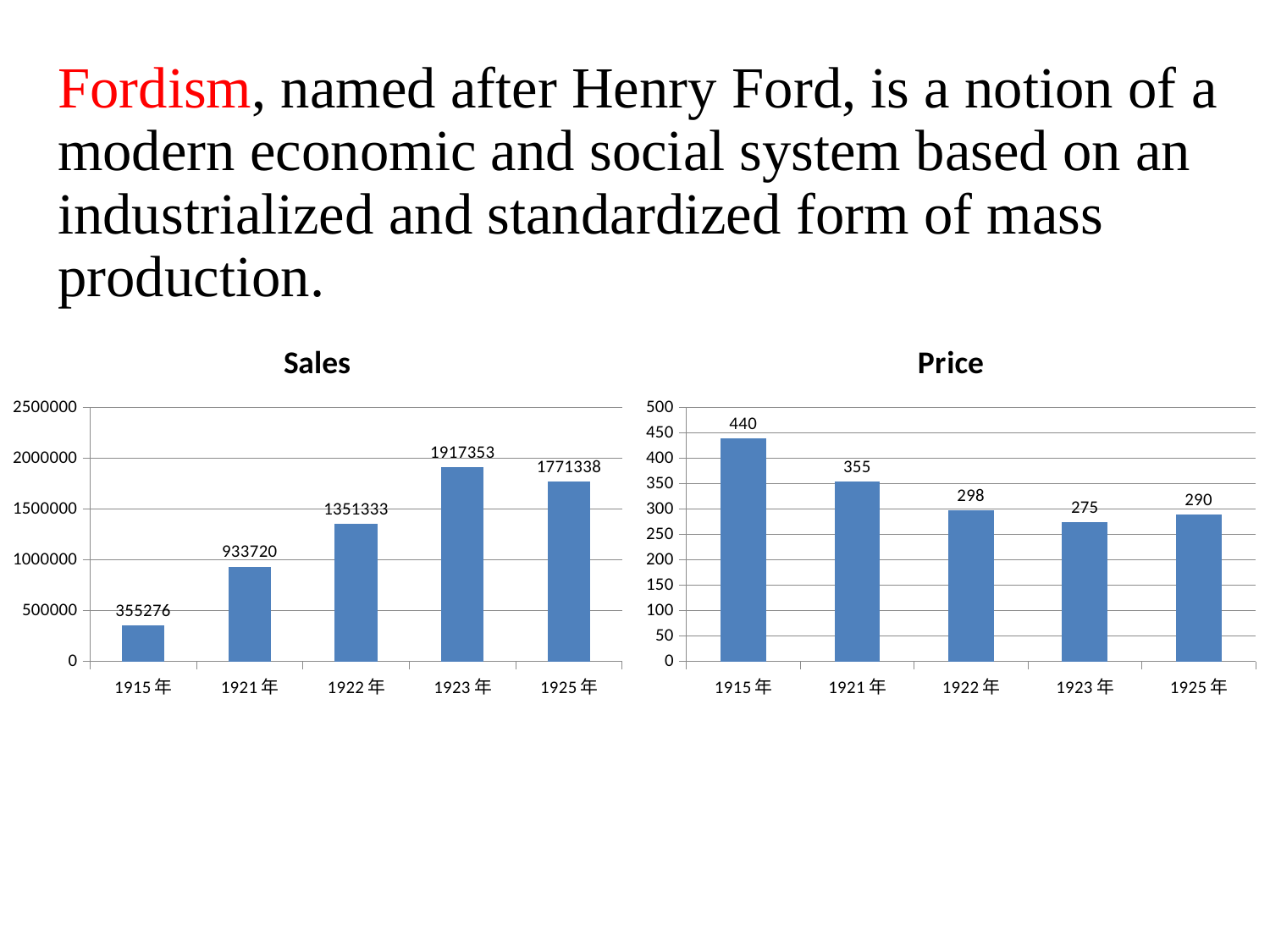
In the Price chart, which year has the lowest value? 1923年 In the Sales chart, what is the value for 1915年? 355276 In the Price chart, which year has the highest value? 1915年 In the Price chart, what is the difference between the values for 1915年 and 1921年? 85 In the Price chart, what is the value for 1925年? 290 In the Sales chart, what is the difference between the values for 1923年 and 1925年? 146015 In the Sales chart, which is larger, the value for 1921年 or the value for 1922年? 1922年 In the Price chart, what is the value for 1921年? 355 What kind of chart is the Sales chart? bar chart In the Sales chart, what is the value for 1923年? 1917353 How many categories are shown in the Price chart? 5 In the Sales chart, which year has the highest value? 1923年